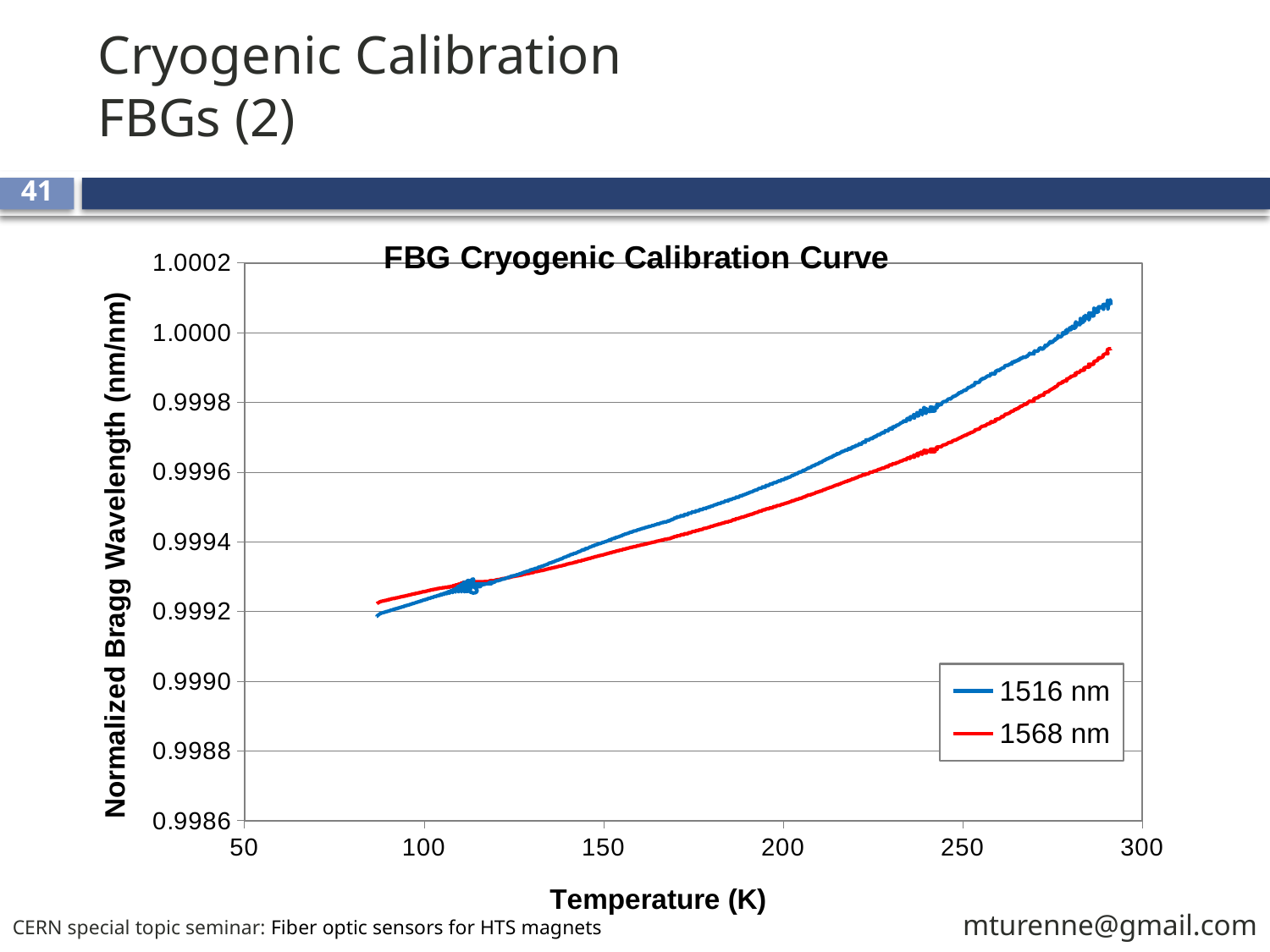
What kind of chart is shown on the slide? line chart Is the value for the 1568 nm series at 250 K greater or less than 0.9998? less Is the value for the 1516 nm series at 290 K greater or less than 1.0000? greater At 250 K, which series has the higher normalized Bragg wavelength, 1516 nm or 1568 nm? 1516 nm Is the value for the 1568 nm series at 290 K greater or less than 1.0000? less How many series does the legend list? 2 What is the title of the chart? FBG Cryogenic Calibration Curve Do the values of the 1568 nm series rise or fall as temperature increases? rise Do the values of the 1516 nm series rise or fall as temperature increases? rise What is the label of the x axis? Temperature (K) At 100 K, which series has the higher normalized Bragg wavelength, 1516 nm or 1568 nm? 1568 nm